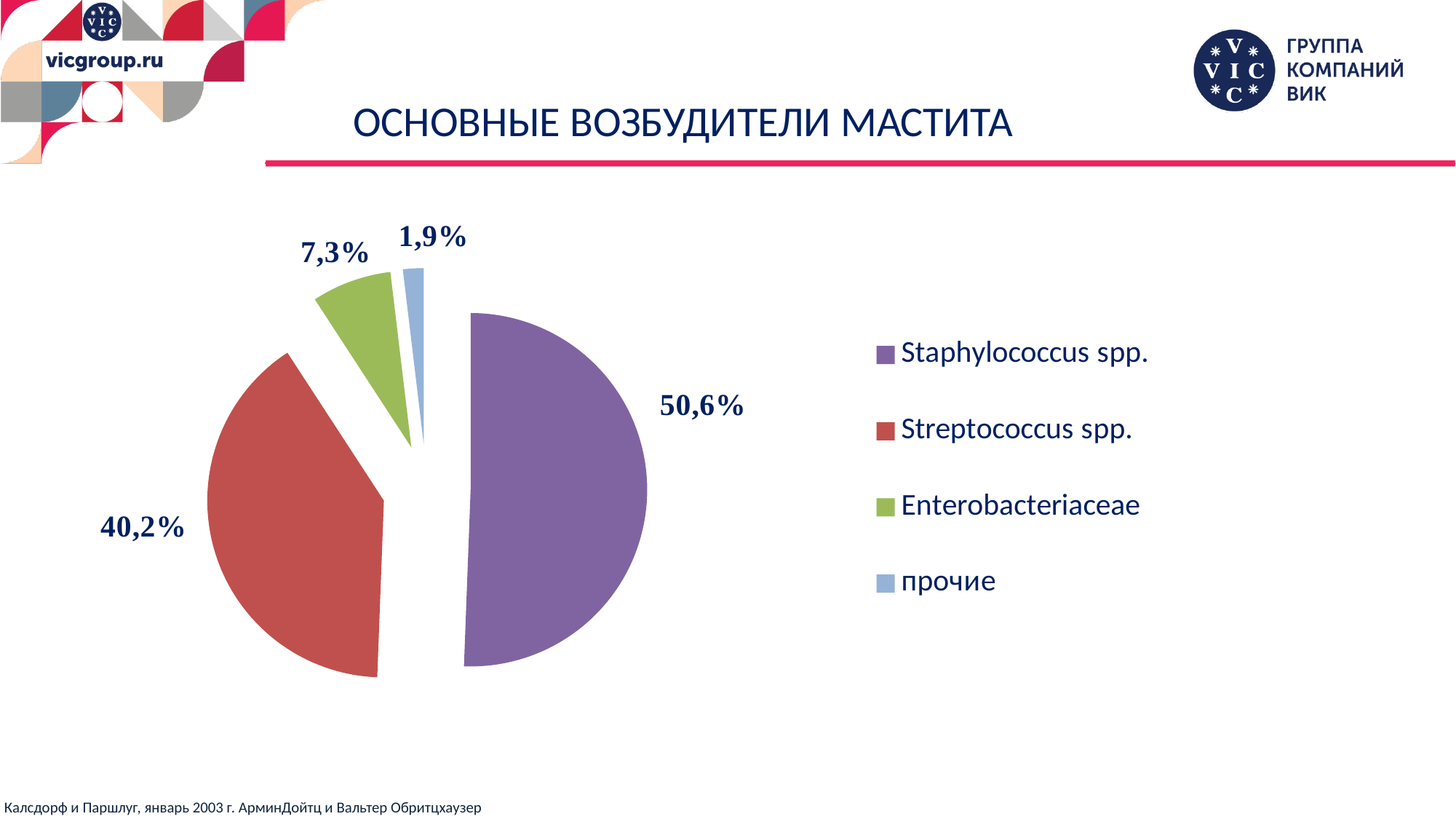
What is the title of the slide? ОСНОВНЫЕ ВОЗБУДИТЕЛИ МАСТИТА What is the value shown for Streptococcus spp.? 40,2% What share of the pie does Staphylococcus spp. account for? 50,6% Which category has the largest slice of the pie? Staphylococcus spp. What is the value shown for the 'прочие' slice? 1,9% What colour is the Streptococcus spp. slice? Red What is the value shown for Enterobacteriaceae? 7,3% Which category has the smallest slice of the pie? прочие How many categories does the pie chart show? 4 What kind of chart is shown on the slide? Pie chart What is the difference between the Staphylococcus spp. and Streptococcus spp. values? 10,4% Which is larger, Enterobacteriaceae or прочие? Enterobacteriaceae